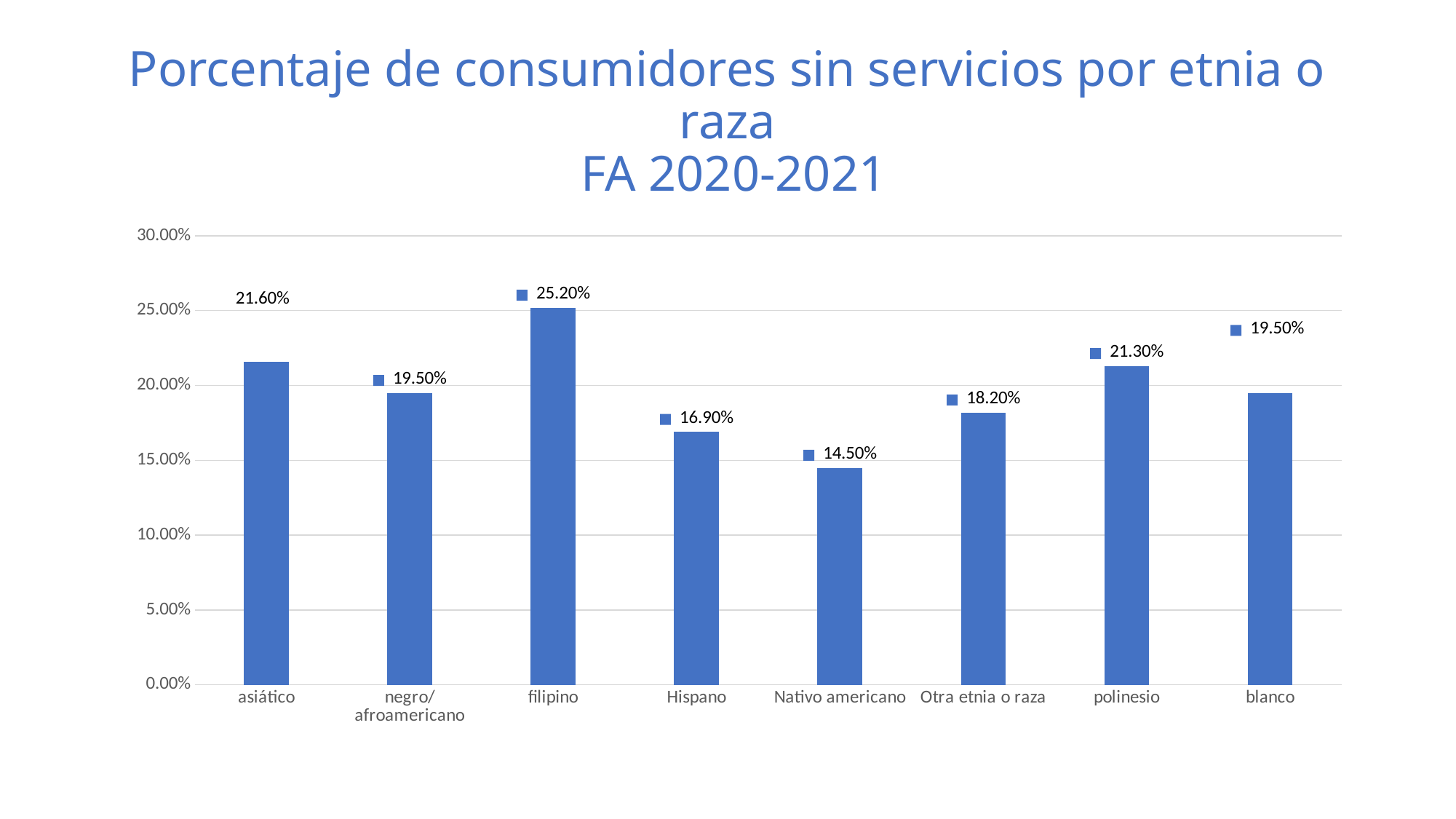
What is the title of the chart? Porcentaje de consumidores sin servicios por etnia o raza FA 2020-2021 Which category has the highest value? filipino What is the value for Nativo americano? 14.50% What is the value for filipino? 25.20% Which is larger, the value for asiático or the value for polinesio? asiático What kind of chart is shown on the slide? bar chart What is the value for polinesio? 21.30% What is the value for Otra etnia o raza? 18.20% What is the difference between the values for filipino and Hispano? 8.30% How many categories are shown on the x axis? 8 Which category has the lowest value? Nativo americano Is the value for Hispano greater or less than 20.00%? less